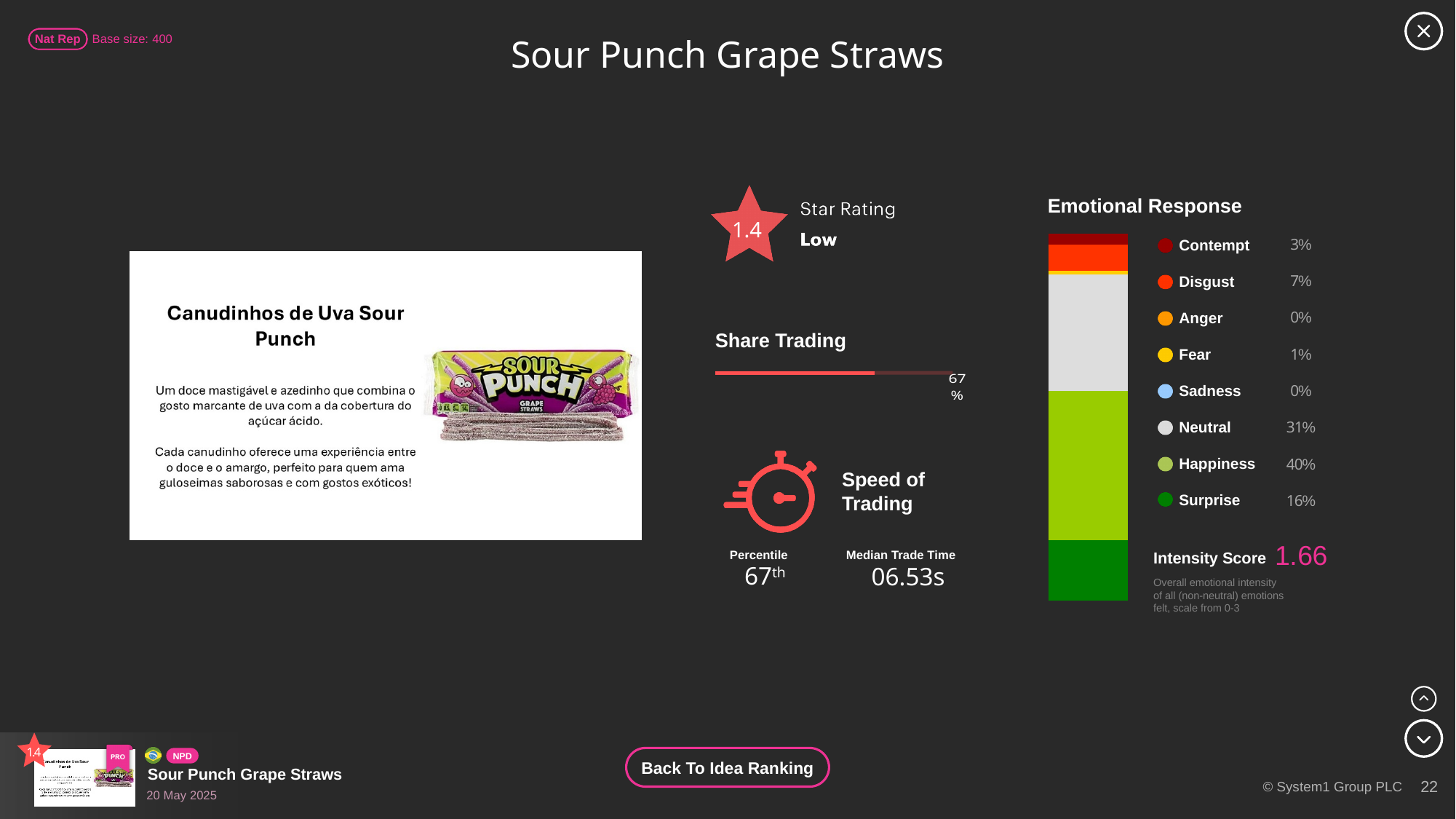
What kind of chart is the Emotional Response chart? Stacked bar chart What is the Intensity Score shown next to the Emotional Response chart? 1.66 What percentage is shown on the Share Trading bar? 67% In the Emotional Response chart, what percentage is shown for Disgust? 7% How many emotions are listed in the Emotional Response chart legend? 8 In the Emotional Response chart, what percentage is shown for Neutral? 31% In the Emotional Response chart, which emotion has the highest percentage? Happiness In the Emotional Response chart, which is larger, Disgust or Contempt? Disgust In the Emotional Response chart, what is the difference between the Surprise and Contempt percentages? 13% In the Emotional Response chart, what percentage is shown for Happiness? 40% In the Emotional Response chart, what is the difference between the Happiness and Neutral percentages? 9% In the Emotional Response chart, what percentage is shown for Surprise? 16%